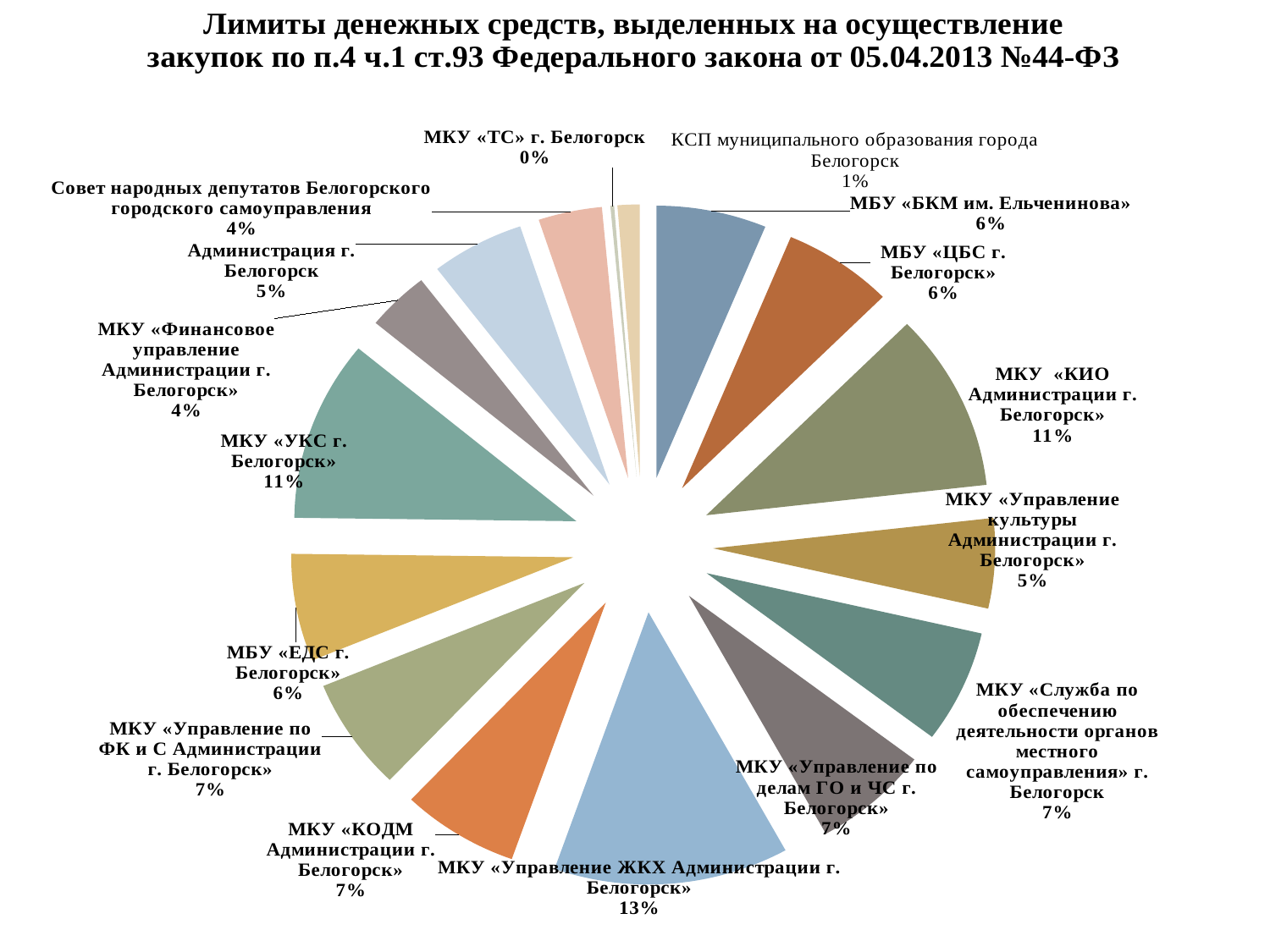
Which is larger: the share for МКУ «КОДМ Администрации г. Белогорск» or the share for Администрация г. Белогорск? МКУ «КОДМ Администрации г. Белогорск» What percentage is shown for КСП муниципального образования города Белогорск? 1% Which category has the smallest slice of the pie? МКУ «ТС» г. Белогорск What share of the pie does МКУ «КИО Администрации г. Белогорск» have? 11% What kind of chart is shown on the slide? pie chart What percentage is shown for Совет народных депутатов Белогорского городского самоуправления? 4% What share of the pie does МКУ «Управление ЖКХ Администрации г. Белогорск» have? 13% What is the title of the chart? Лимиты денежных средств, выделенных на осуществление закупок по п.4 ч.1 ст.93 Федерального закона от 05.04.2013 №44-ФЗ How many categories (slices) does the pie chart have? 16 What is the difference in percentage points between МКУ «Управление ЖКХ Администрации г. Белогорск» and МКУ «УКС г. Белогорск»? 2 What percentage is shown for МБУ «ЕДС г. Белогорск»? 6% Which category has the largest slice of the pie? МКУ «Управление ЖКХ Администрации г. Белогорск»